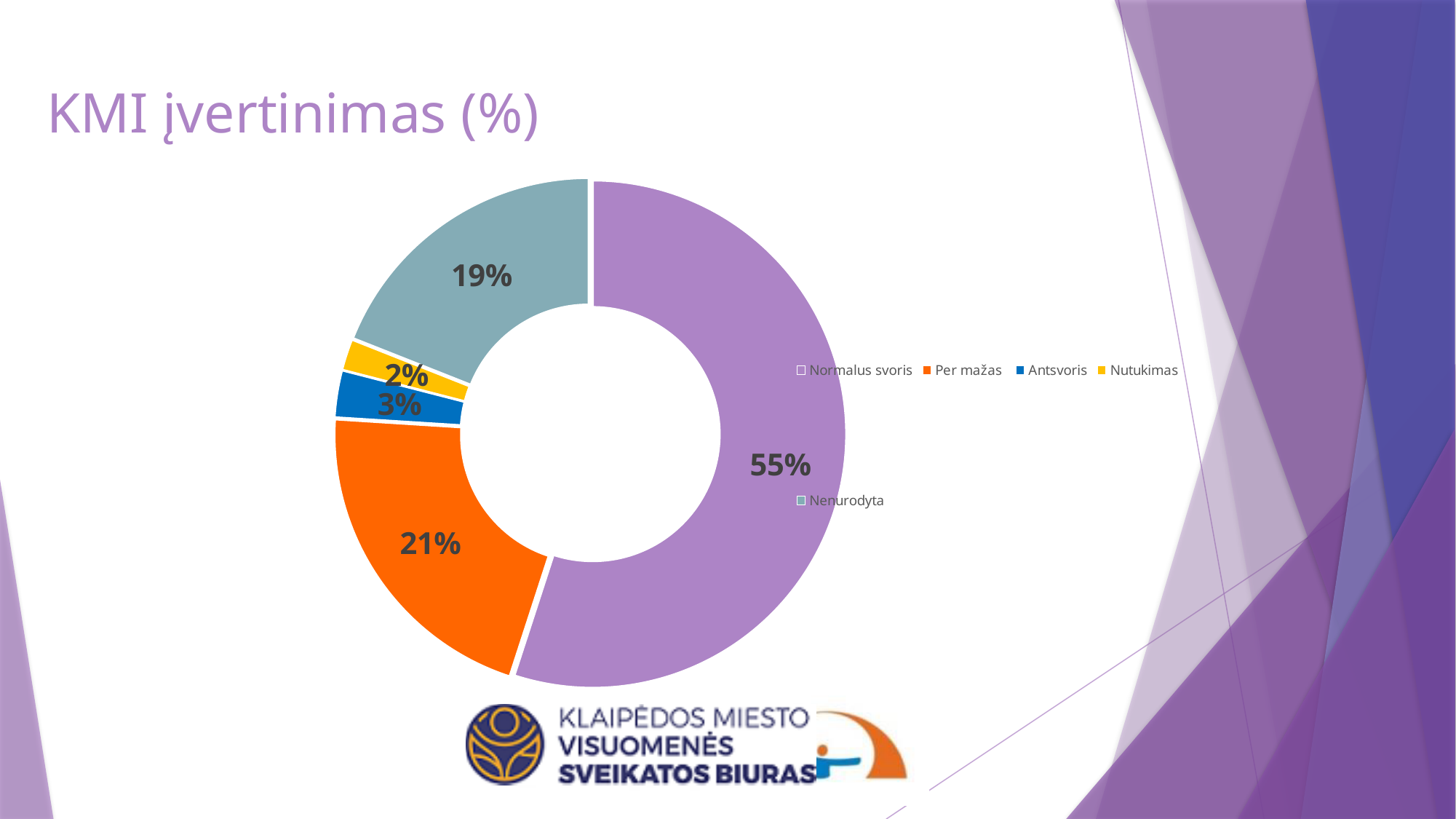
What percentage does the Nutukimas slice show? 2% What kind of chart is shown on the slide? Doughnut chart What is the title of the slide? KMI įvertinimas (%) Which category has the largest share of the chart? Normalus svoris How many categories are shown in the chart? 5 Which category has the smallest share of the chart? Nutukimas What percentage does the Nenurodyta slice show? 19% Which is larger, the share for Per mažas or the share for Nenurodyta? Per mažas What percentage does the Per mažas slice show? 21% What percentage does the Antsvoris slice show? 3% What is the difference in percentage points between Normalus svoris and Per mažas? 34 What percentage does the Normalus svoris slice show? 55%